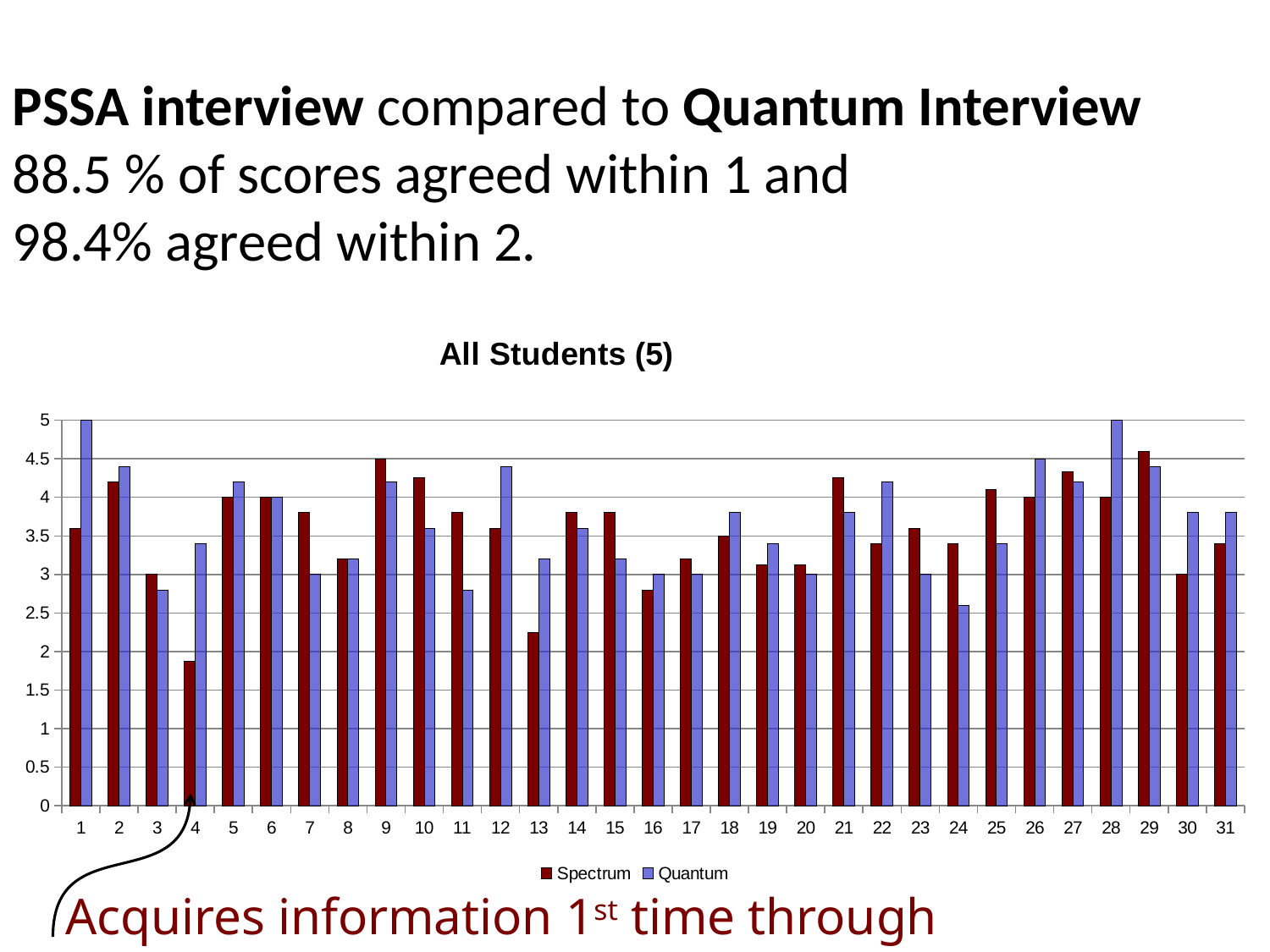
For student 4, which series has the larger value, Spectrum or Quantum? Quantum Is the Spectrum value for student 4 greater or less than 2? less What is the Quantum value for student 1? 5 How many series does the legend list? 2 What type of chart is shown on the slide? bar chart Is the Quantum value for student 12 greater or less than 4? greater What is the Spectrum value for student 30? 3 Which student has the lowest Spectrum value? 4 What is the title of the chart? All Students (5) What is the Spectrum value for student 6? 4 For student 11, which series has the larger value, Spectrum or Quantum? Spectrum How many students (categories) are plotted along the x axis? 31